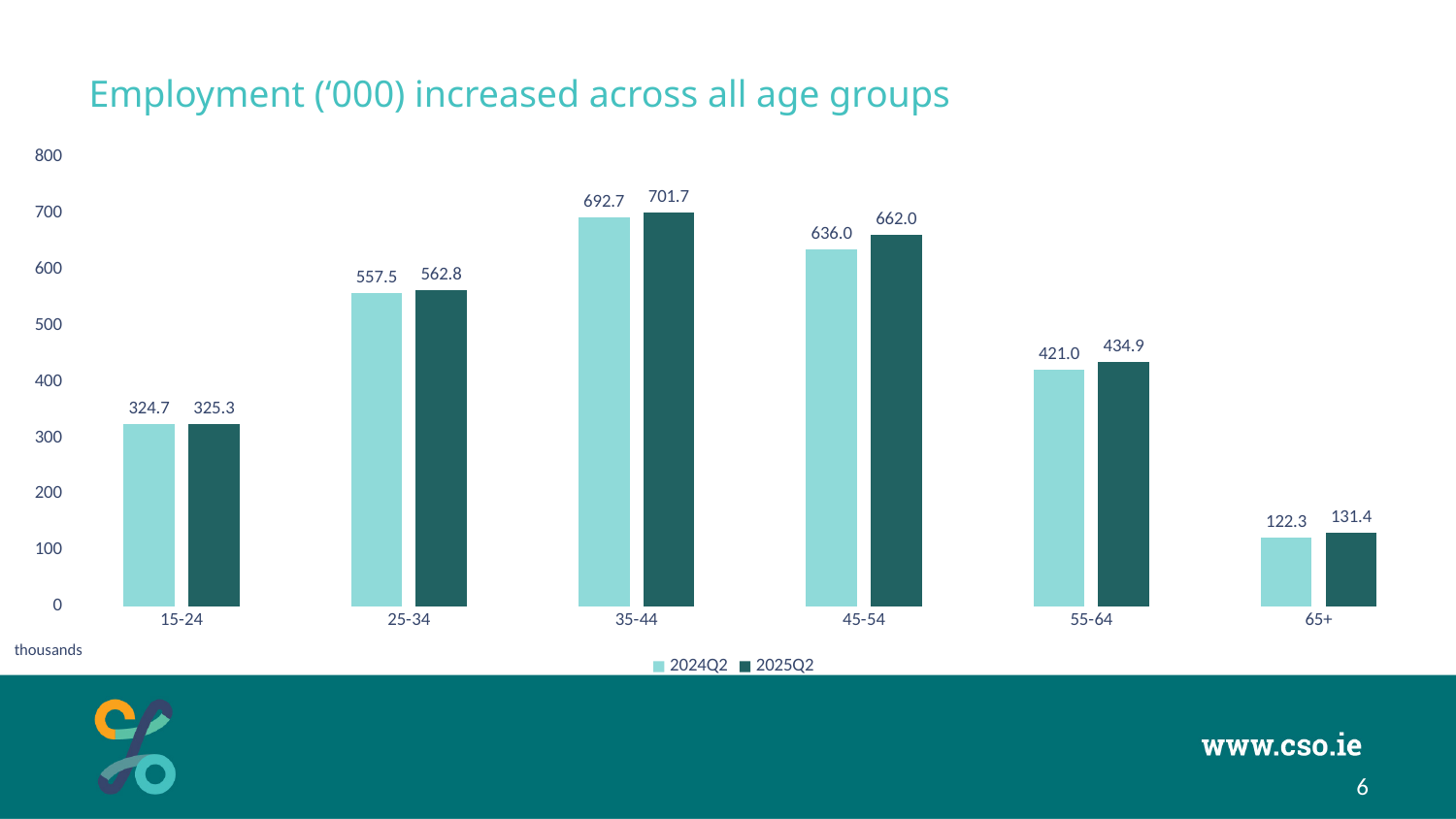
Which age group has the lowest 2024Q2 employment value? 65+ What is the difference between the 2025Q2 and 2024Q2 values for the 65+ age group? 9.1 What kind of chart is shown on the slide? Bar chart Which age group has the highest 2025Q2 employment value? 35-44 Which is larger for the 25-34 age group: the 2024Q2 value or the 2025Q2 value? 2025Q2 What is the difference between the 2025Q2 and 2024Q2 values for the 45-54 age group? 26.0 How many series does the legend list? 2 What is the 2024Q2 employment value for the 55-64 age group? 421.0 What is the title of the chart? Employment ('000) increased across all age groups What is the 2025Q2 employment value for the 35-44 age group? 701.7 How many age groups are shown on the x axis? 6 Is the 2025Q2 value for the 55-64 age group greater or less than 400? greater